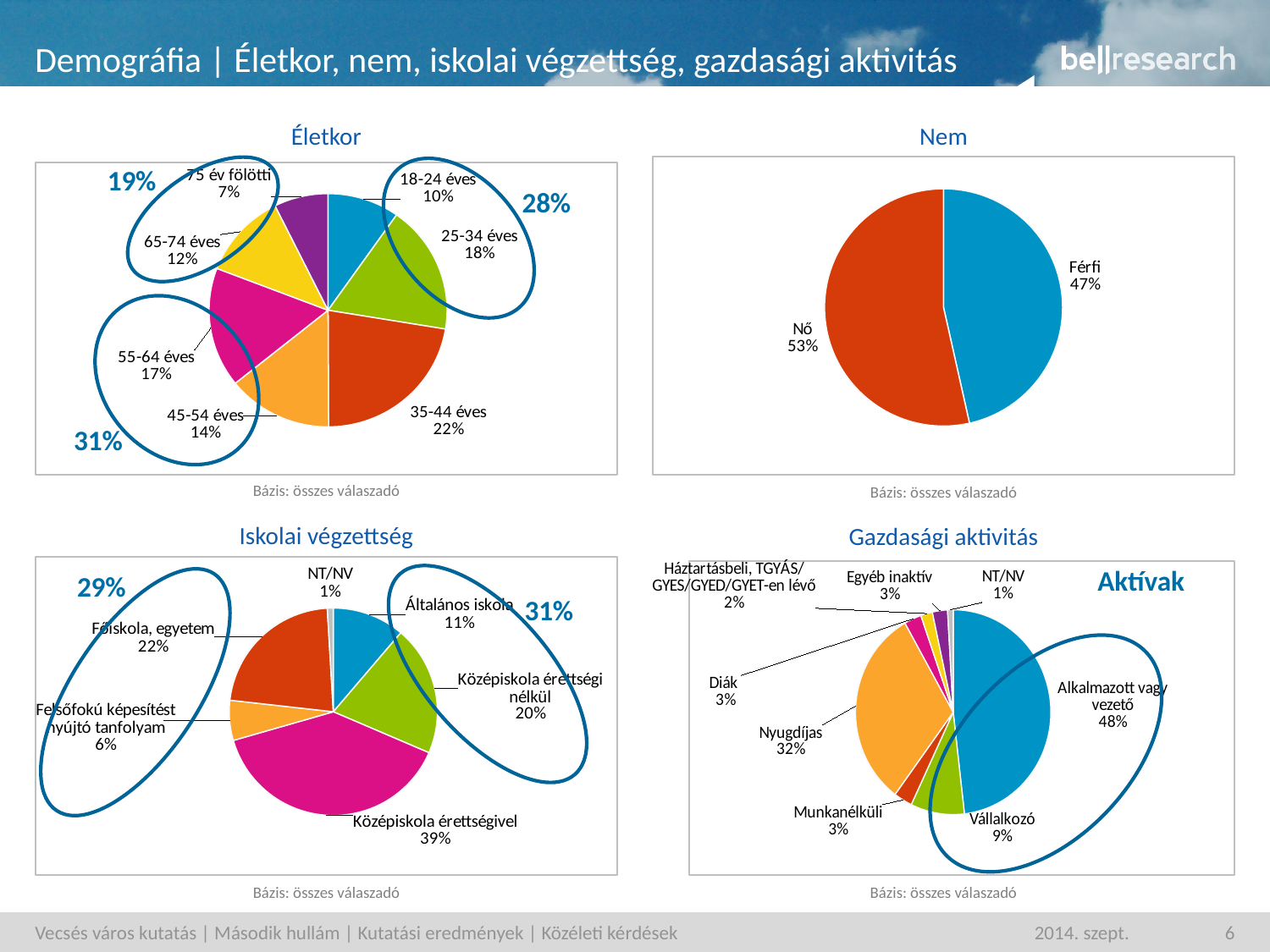
In the Gazdasági aktivitás chart, what share of respondents are Nyugdíjas? 32% In the Gazdasági aktivitás chart, how many categories are shown? 8 In the Iskolai végzettség chart, what share of respondents have Főiskola, egyetem? 22% In the Életkor chart, what is the difference between the shares of 25-34 éves and 65-74 éves? 6 percentage points In the Iskolai végzettség chart, which category has the largest share? Középiskola érettségivel What kind of chart is the Nem chart? Pie chart In the Gazdasági aktivitás chart, what is the combined share of Alkalmazott vagy vezető and Vállalkozó? 57% In the Életkor chart, which age group has the smallest share? 75 év fölötti In the Életkor chart, how many age categories are shown? 7 In the Nem chart, which is larger, Férfi or Nő? Nő In the Életkor chart, what share of respondents are 35-44 éves? 22% In the Nem chart, what share of respondents are Nő? 53%